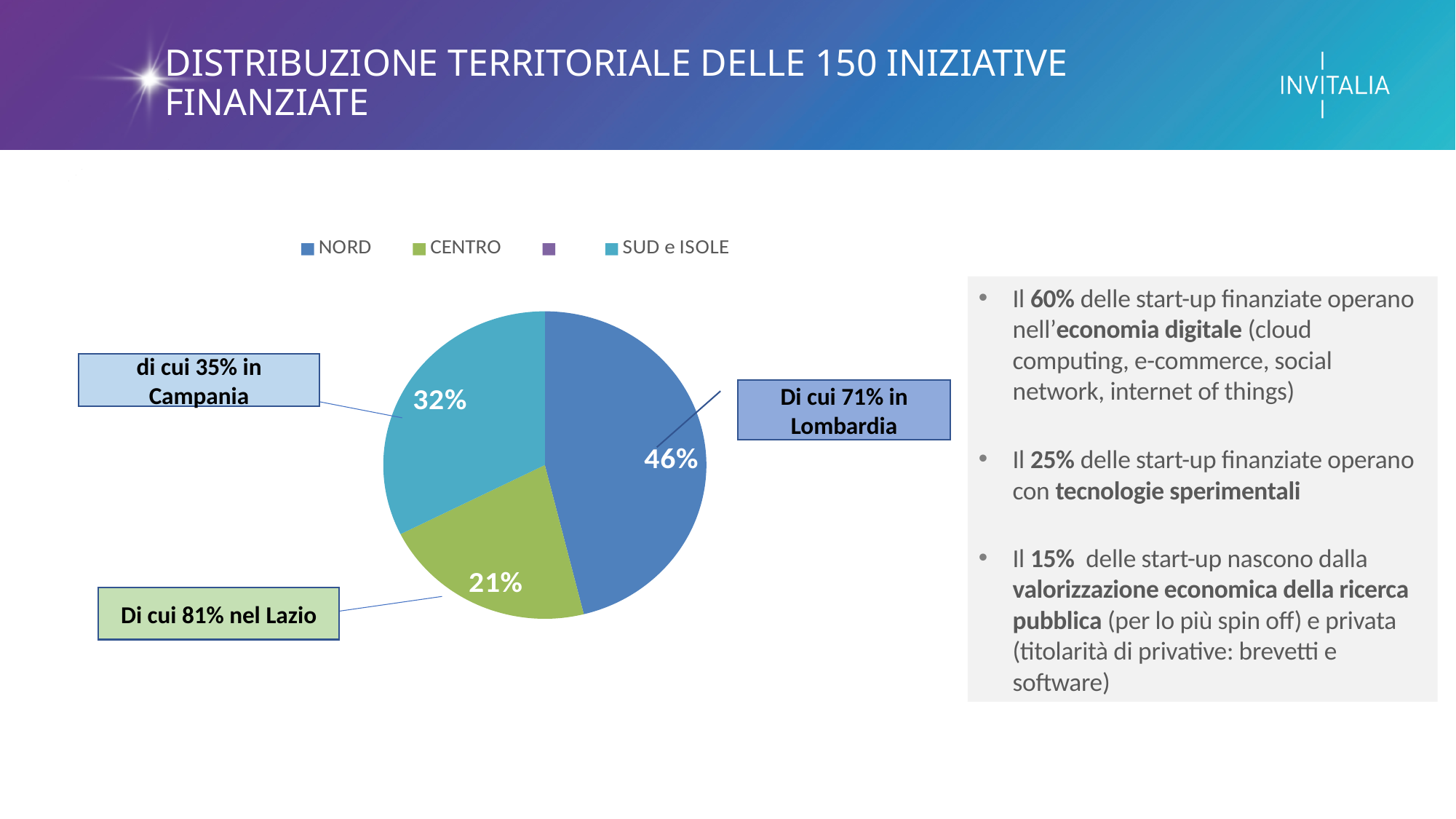
Which is larger, the SUD e ISOLE slice or the CENTRO slice? SUD e ISOLE What kind of chart is shown on the slide? pie chart What share of the pie does SUD e ISOLE represent? 32% What share of the pie does NORD represent? 46% According to the callout on the pie chart, what percentage of the NORD initiatives are in Lombardia? 71% What colour is the CENTRO slice in the pie chart? green What is the difference in percentage points between the SUD e ISOLE and CENTRO slices? 11 How many slices are shown in the pie chart? 3 What share of the pie does CENTRO represent? 21% Which slice of the pie is the largest? NORD Which slice of the pie is the smallest? CENTRO What is the difference in percentage points between the NORD and CENTRO slices? 25